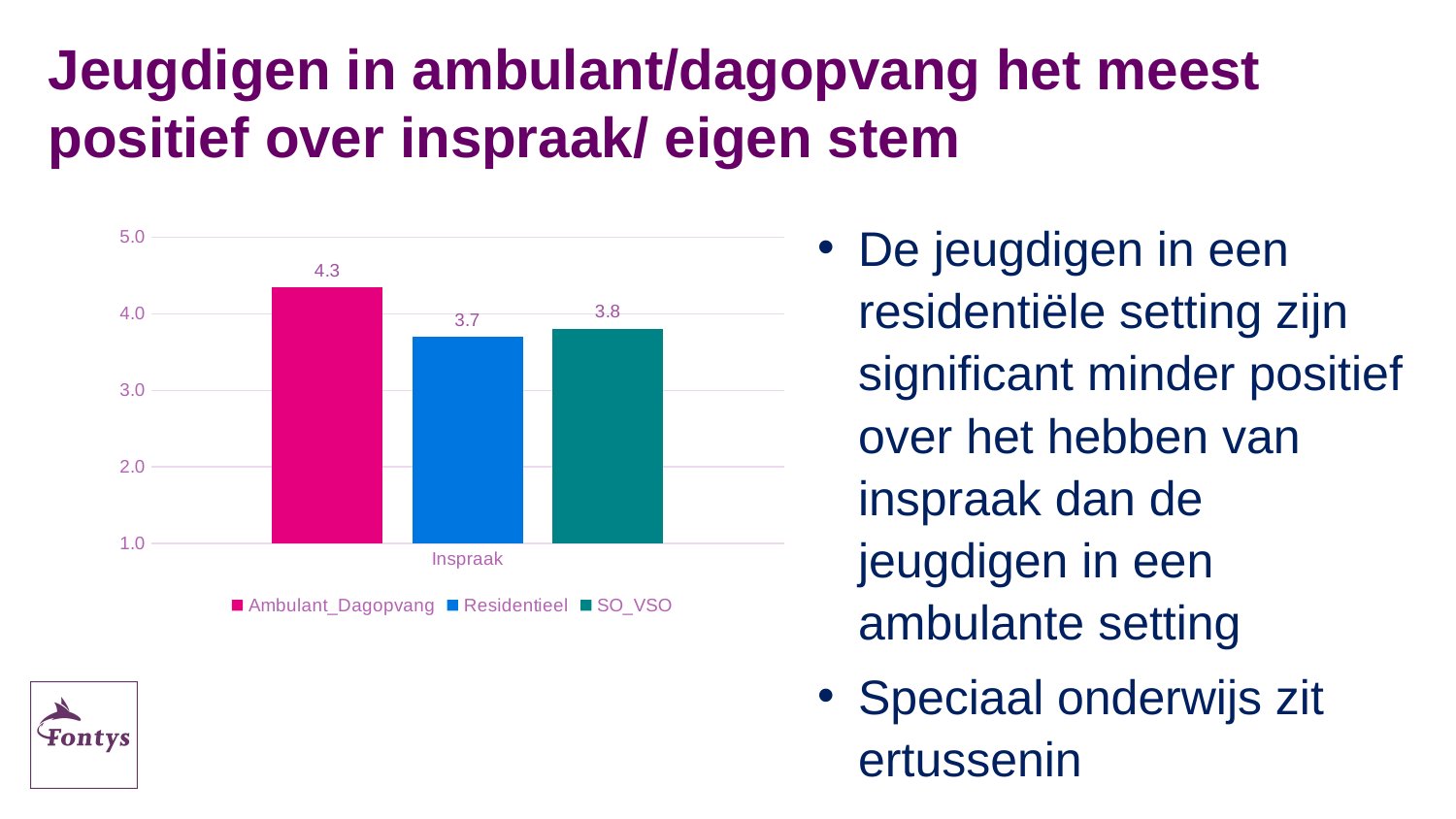
Which series has the lowest value for Inspraak? Residentieel Is the value for Ambulant_Dagopvang greater or less than 4.0? greater What is the value for Residentieel on the Inspraak chart? 3.7 How many categories are shown on the x axis of the chart? 1 What kind of chart is shown on the slide? bar chart What is the value for Ambulant_Dagopvang on the Inspraak chart? 4.3 Which is larger for Inspraak, the Residentieel value or the SO_VSO value? SO_VSO What is the difference between the Ambulant_Dagopvang and SO_VSO values for Inspraak? 0.5 What is the value for SO_VSO on the Inspraak chart? 3.8 Which series has the highest value for Inspraak? Ambulant_Dagopvang How many series does the legend list? 3 What is the difference between the Ambulant_Dagopvang and Residentieel values for Inspraak? 0.6